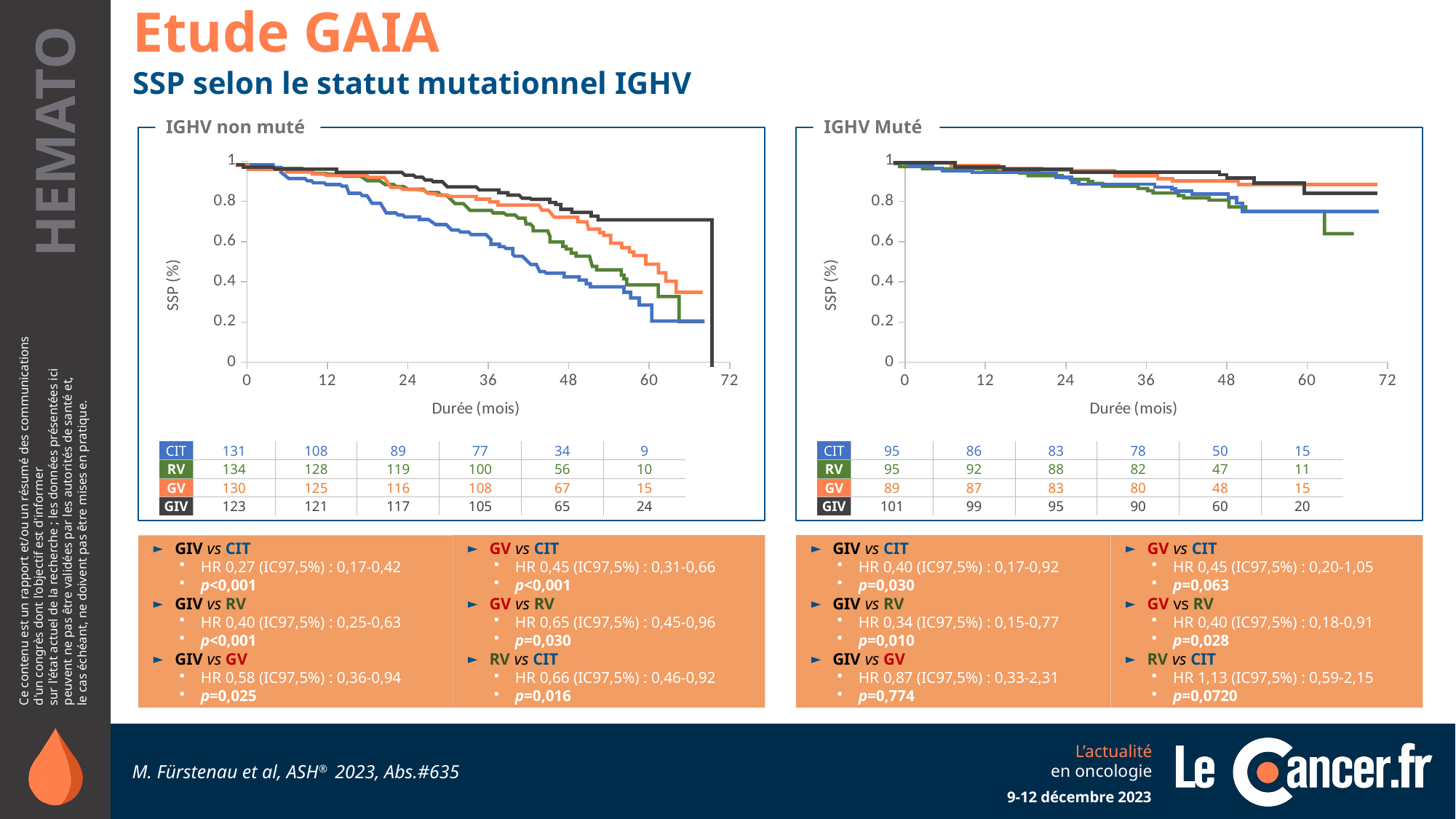
In the 'IGHV non muté' panel, which group has the highest number at risk at 0 months? RV In the 'IGHV Muté' panel, which group has more patients at risk at 48 months, GIV or RV? GIV In the 'IGHV non muté' chart, do the survival curves rise or fall as the duration increases? fall In the 'IGHV non muté' chart, is the value of the GIV curve at 60 months greater or less than 0.6? greater What kind of chart is shown in the 'IGHV non muté' panel? line chart In the 'IGHV Muté' chart, what is the label of the x axis? Durée (mois) In the 'IGHV non muté' panel, what is the difference between the number at risk for GIV and for CIT at 60 months? 15 In the 'IGHV non muté' chart, is the value of the CIT curve at 48 months greater or less than 0.6? less In the 'IGHV non muté' panel, how many patients at risk are listed for CIT at 0 months? 131 In the 'IGHV Muté' panel, which group has the highest number at risk at 0 months? GIV In the 'IGHV Muté' chart, is the value of the GV curve at 60 months greater or less than 0.8? greater In the 'IGHV non muté' chart, how many treatment groups (curves) are plotted? 4